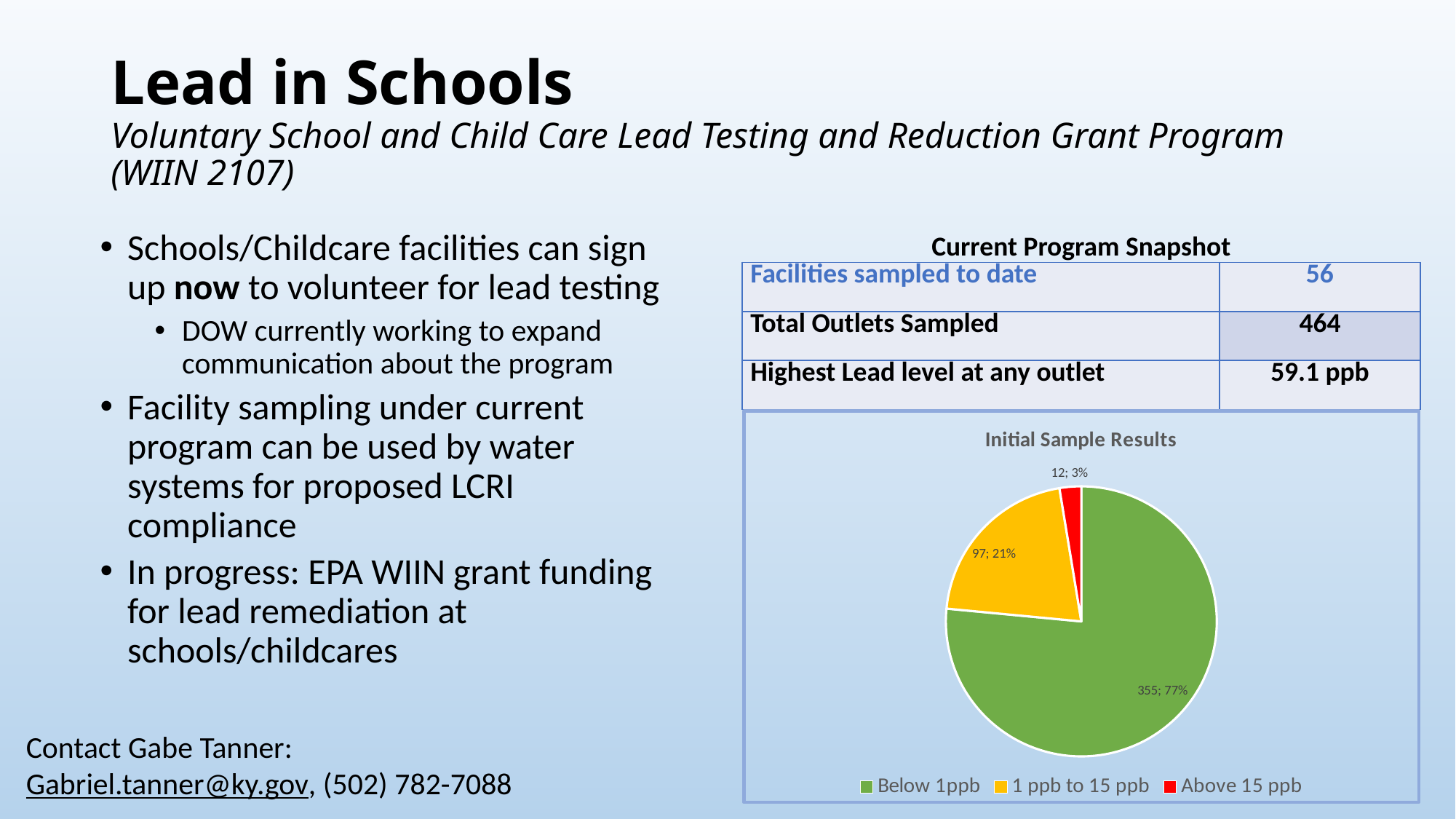
How many entries does the chart legend list? 3 How many slices does the pie chart have? 3 What is the title of the chart? Initial Sample Results How many samples were Above 15 ppb? 12 What type of chart is shown on the slide? pie chart What share of the pie is the Above 15 ppb slice? 3% How many samples were in the 1 ppb to 15 ppb category? 97 What is the difference in sample count between Below 1ppb and 1 ppb to 15 ppb? 258 Which category has the largest slice? Below 1ppb What share of the pie is the Below 1ppb slice? 77% Which category has the smallest slice? Above 15 ppb How many samples were Below 1ppb? 355